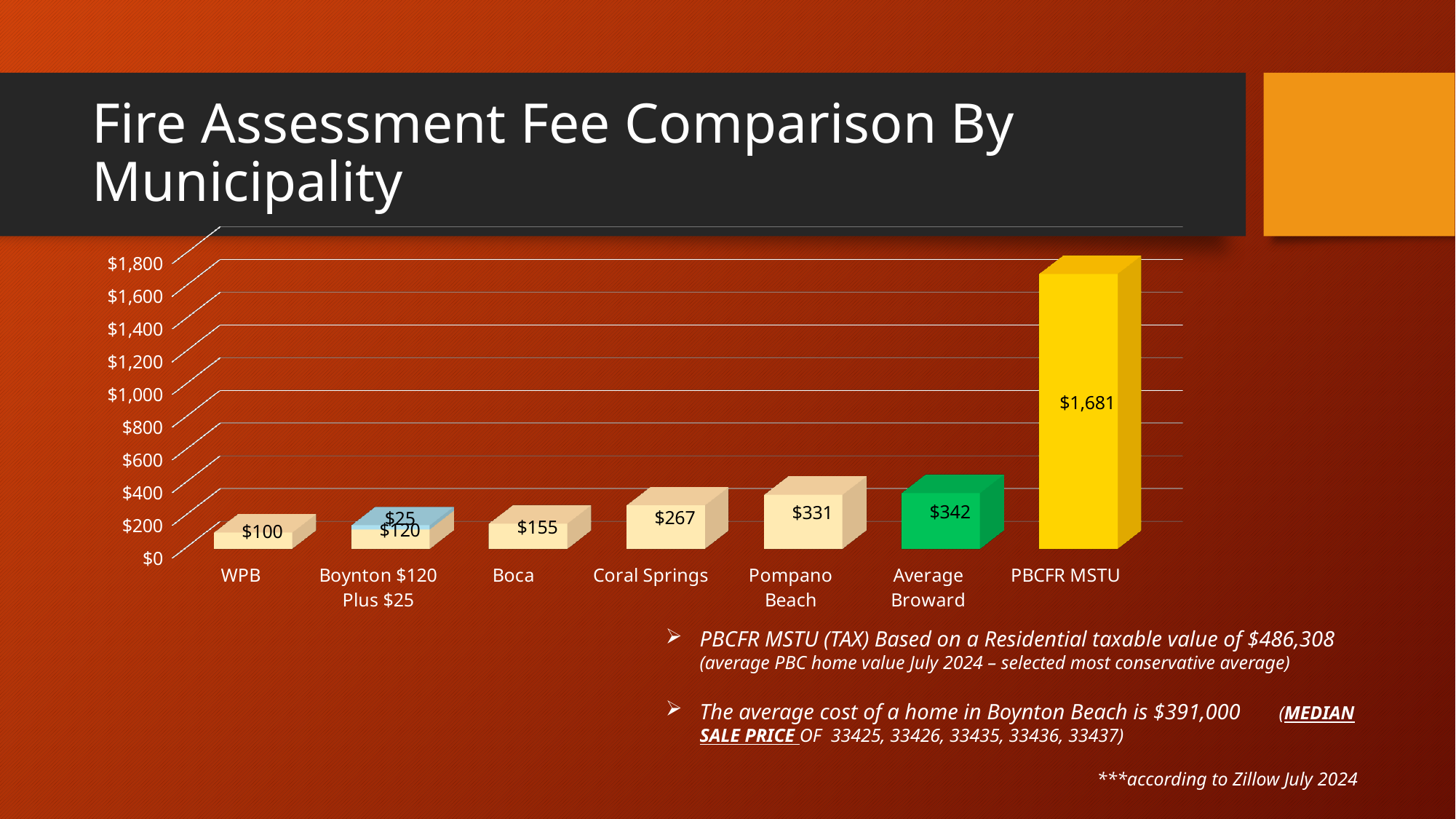
What is the total of the stacked bar for Boynton $120 Plus $25? $145 What is the difference between the PBCFR MSTU value and the Average Broward value? $1,339 Which category has the lowest value? WPB What kind of chart is shown on the slide? Bar chart Which is larger, the value for Pompano Beach or the value for Coral Springs? Pompano Beach What is the value shown for PBCFR MSTU? $1,681 Which category has the highest value? PBCFR MSTU What is the value shown for WPB? $100 What is the value shown for Coral Springs? $267 What is the difference between the Boca value and the WPB value? $55 How many categories are shown on the x axis? 7 What is the value shown for Pompano Beach? $331